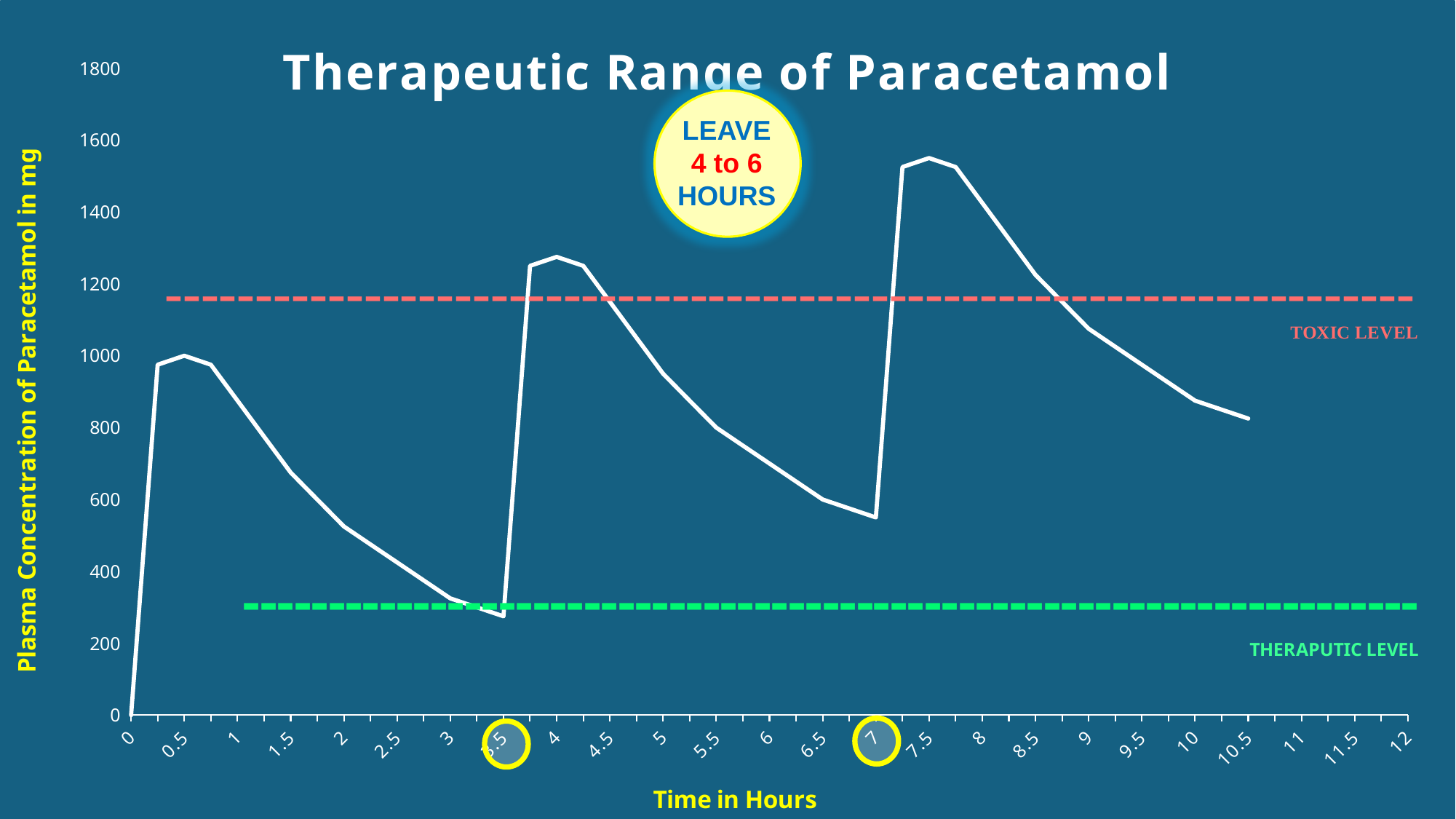
What is the label of the y axis? Plasma Concentration of Paracetamol in mg Which is higher, the peak plasma concentration at 4 hours or the peak at 7.5 hours? 7.5 hours Is the plasma concentration at 9 hours greater or less than 1200? less Is the plasma concentration at 7.5 hours greater or less than 1400? greater At which time in hours does the plasma concentration line reach its highest point? 7.5 What kind of chart is shown on the slide? line chart Is the plasma concentration at 2 hours greater or less than 400? greater Between 0.5 hours and 3.5 hours, does the plasma concentration rise or fall? fall What is the title of the chart? Therapeutic Range of Paracetamol